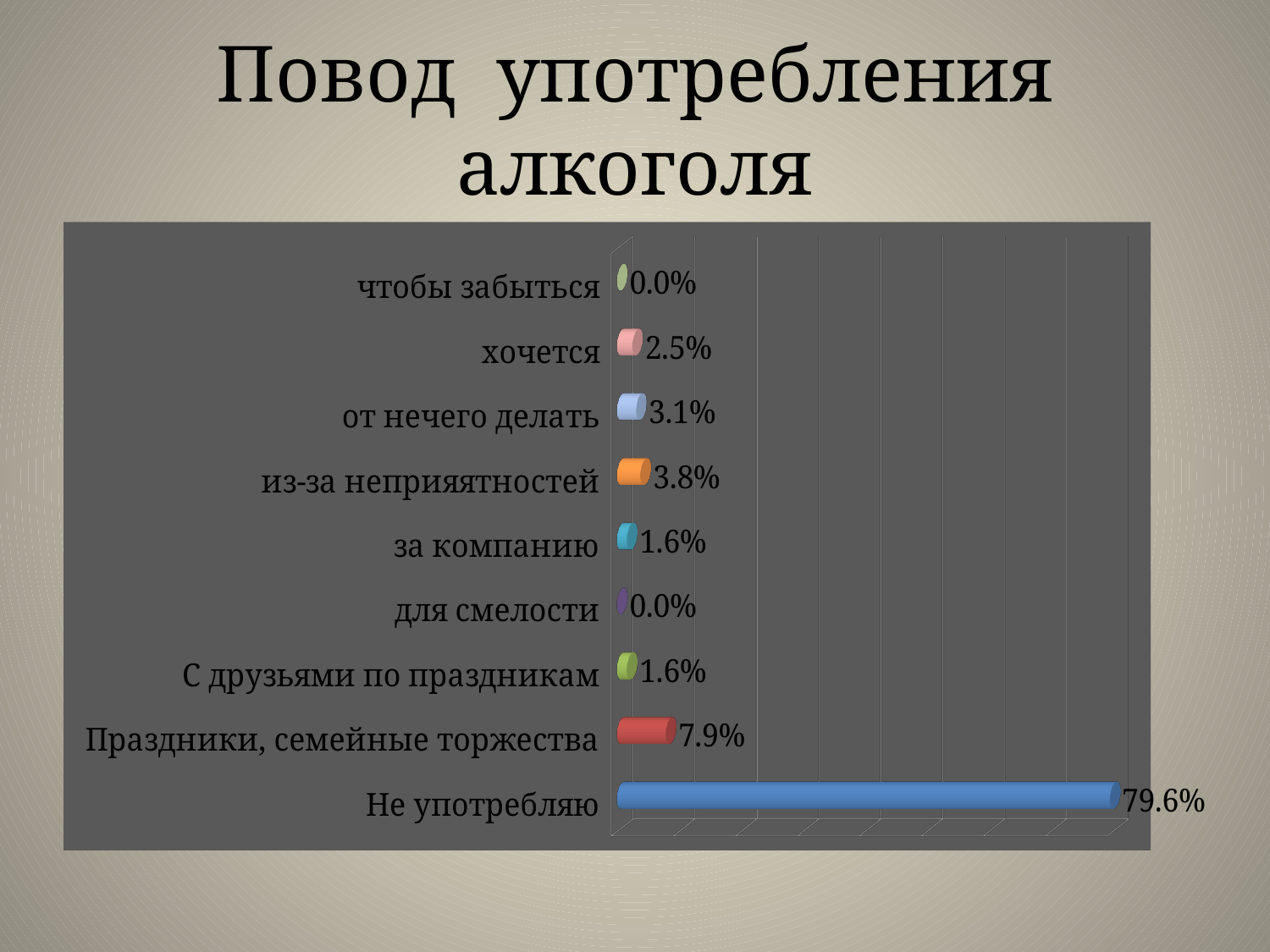
What kind of chart is shown on the slide? bar chart What is the value for "Праздники, семейные торжества"? 7.9% What is the difference between the values for "из-за неприяятностей" and "от нечего делать"? 0.7% What is the difference between the values for "Не употребляю" and "Праздники, семейные торжества"? 71.7% What is the value for "хочется"? 2.5% What is the value for "из-за неприяятностей"? 3.8% What is the value for "Не употребляю"? 79.6% Which category has the highest value? Не употребляю How many categories are shown in the chart? 9 How many categories have a value of 0.0%? 2 Which is larger, the value for "хочется" or the value for "за компанию"? хочется What is the title of the slide? Повод употребления алкоголя